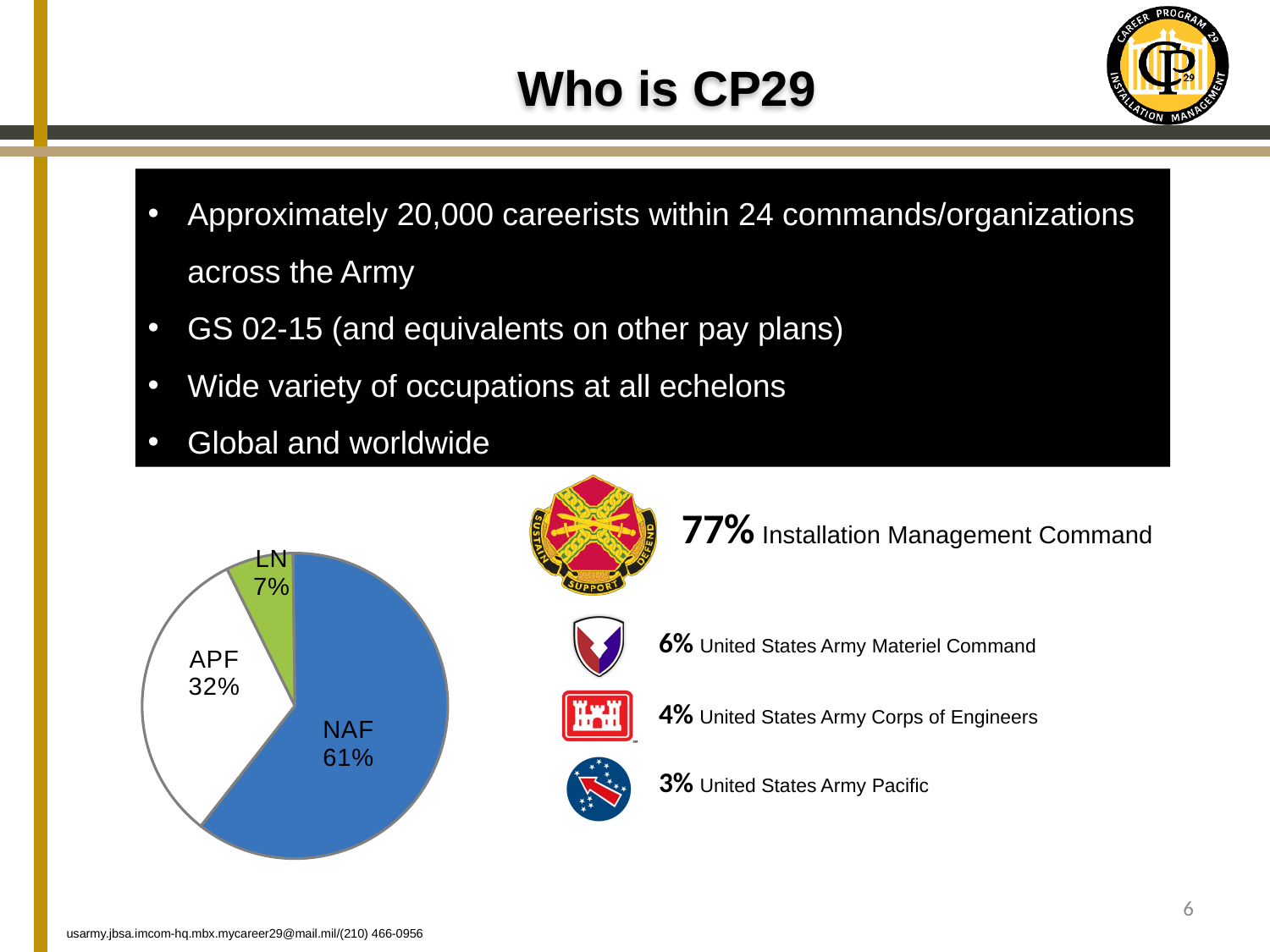
Which slice of the pie chart is the largest? NAF How many slices does the pie chart have? 3 What share of the pie does LN represent? 7% What share of the pie does NAF represent? 61% What is the difference in percentage points between the APF and LN slices? 25 Which slice is larger, NAF or APF? NAF What colour is the NAF slice of the pie chart? blue What share of the pie does APF represent? 32% What kind of chart is shown on the slide? pie chart Which slice is larger, APF or LN? APF Which slice of the pie chart is the smallest? LN What is the difference in percentage points between the NAF and APF slices? 29